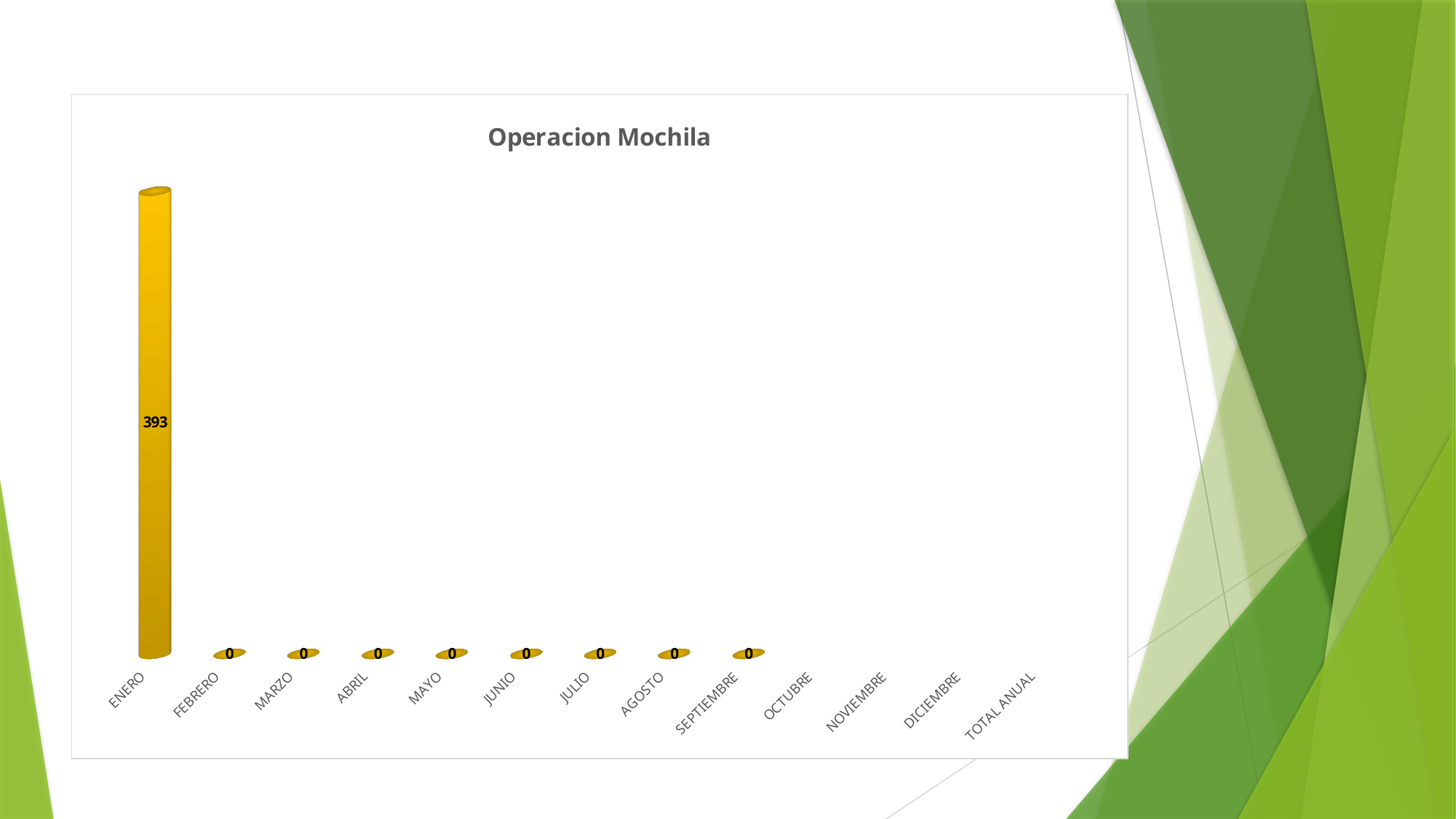
What kind of chart is this? Bar chart Does the value rise or fall from ENERO to FEBRERO? Fall What is the value for ENERO? 393 What is the value for SEPTIEMBRE? 0 What is the value for AGOSTO? 0 What is the title of the chart? Operacion Mochila What is the value for FEBRERO? 0 Which category has the highest value? ENERO What colour are the bars in the chart? Yellow/gold How many categories are shown on the x axis? 13 Which is larger, the value for ENERO or the value for JULIO? ENERO What is the difference between the values for ENERO and MARZO? 393